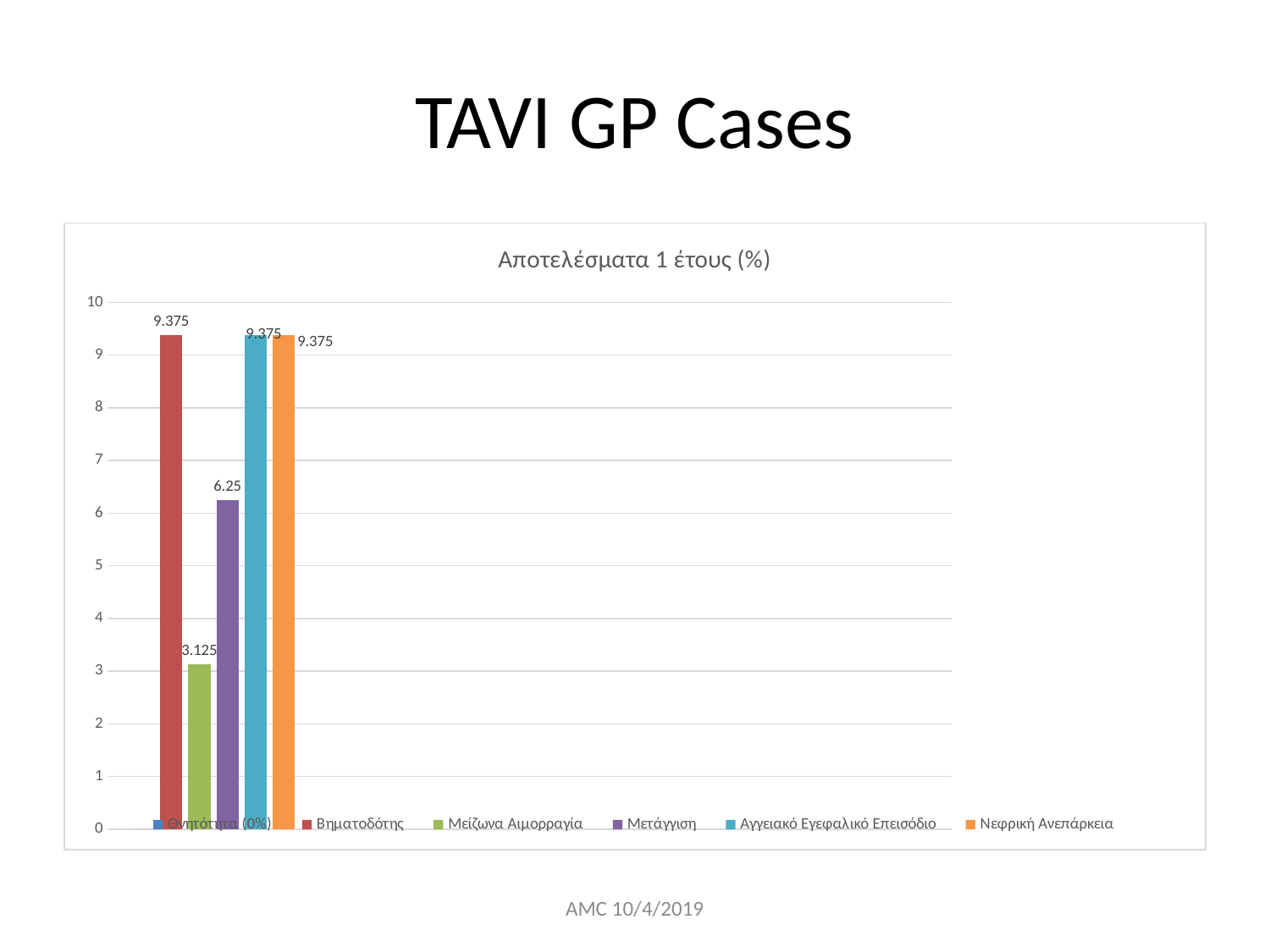
What is the value for Μετάγγιση? 6.25 What is the value for Βηματοδότης? 9.375 What is the value for Μείζωνα Αιμορραγία? 3.125 What is the value for Νεφρική Ανεπάρκεια? 9.375 What is the difference between the values for Μετάγγιση and Μείζωνα Αιμορραγία? 3.125 Is the value for Αγγειακό Εγεφαλικό Επεισόδιο greater or less than 9? greater How many series does the legend list? 6 Which series has the lowest value? Θνητότητα (0%) What is the difference between the values for Βηματοδότης and Μετάγγιση? 3.125 Which is larger, the value for Μετάγγιση or the value for Μείζωνα Αιμορραγία? Μετάγγιση What is the title of the chart? Αποτελέσματα 1 έτους (%) What type of chart is shown on the slide? bar chart